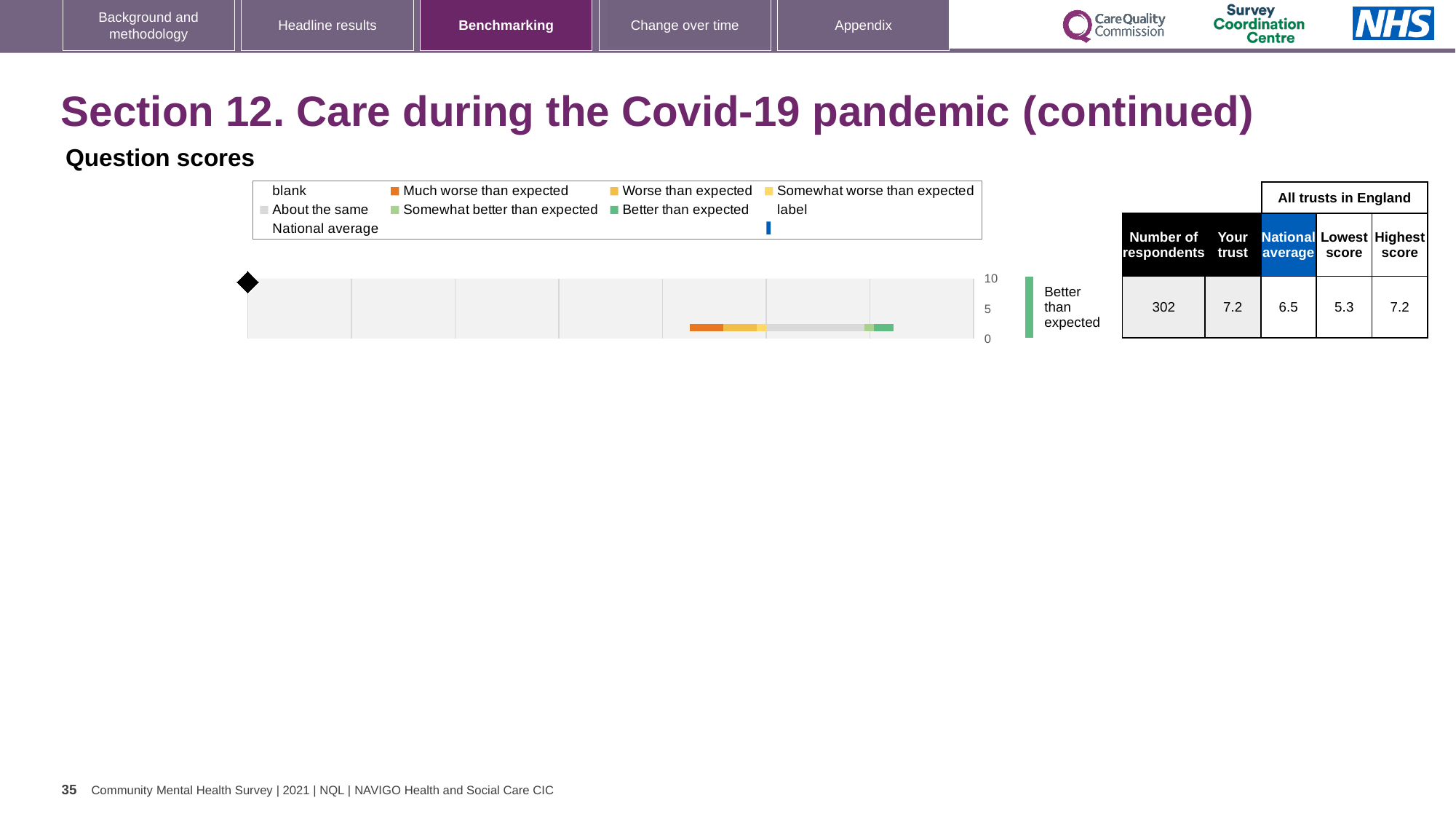
In the table, what is the score for 'Your trust'? 7.2 In the table, what is the highest score among all trusts in England? 7.2 What kind of chart is shown under 'Question scores'? bar chart What is the difference between the highest score and the lowest score among all trusts in England? 1.9 In the table, what is the lowest score among all trusts in England? 5.3 What rating label is printed beside the chart for this question? Better than expected Is the national average score greater or less than 5? greater In the table, what is the number of respondents? 302 Which legend entry is shown in orange? Much worse than expected What is the difference between the 'Your trust' score and the national average? 0.7 Which is larger, the 'Your trust' score or the national average? Your trust In the table, what is the national average score? 6.5